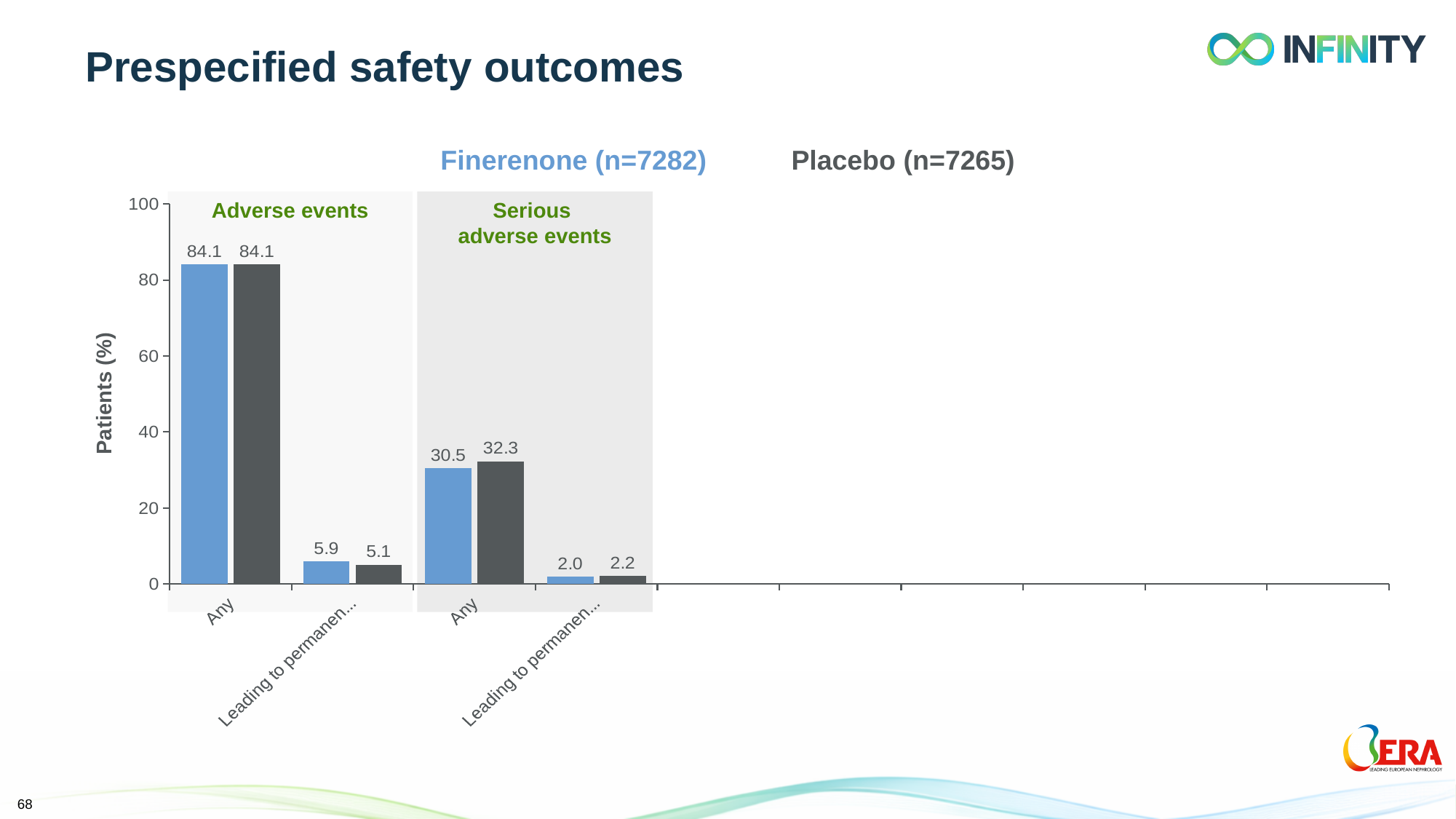
What is the difference between the Placebo and Finerenone values for 'Any' under Serious adverse events? 1.8 What type of chart is shown on the slide? bar chart What is the difference between the Finerenone and Placebo values for 'Leading to permanen...' under Adverse events? 0.8 What is the Finerenone value for the 'Leading to permanen...' category under Serious adverse events? 2.0 Which category has the lowest Finerenone value? Leading to permanen... under Serious adverse events What is the Placebo value for 'Any' under Serious adverse events? 32.3 What is the Placebo value for the 'Leading to permanen...' category under Adverse events? 5.1 Which is larger for 'Any' under Serious adverse events, Finerenone or Placebo? Placebo What is the label of the y axis? Patients (%) What is the Finerenone value for 'Any' under Adverse events? 84.1 What is the Finerenone value for 'Any' under Serious adverse events? 30.5 How many series does the chart show? 2